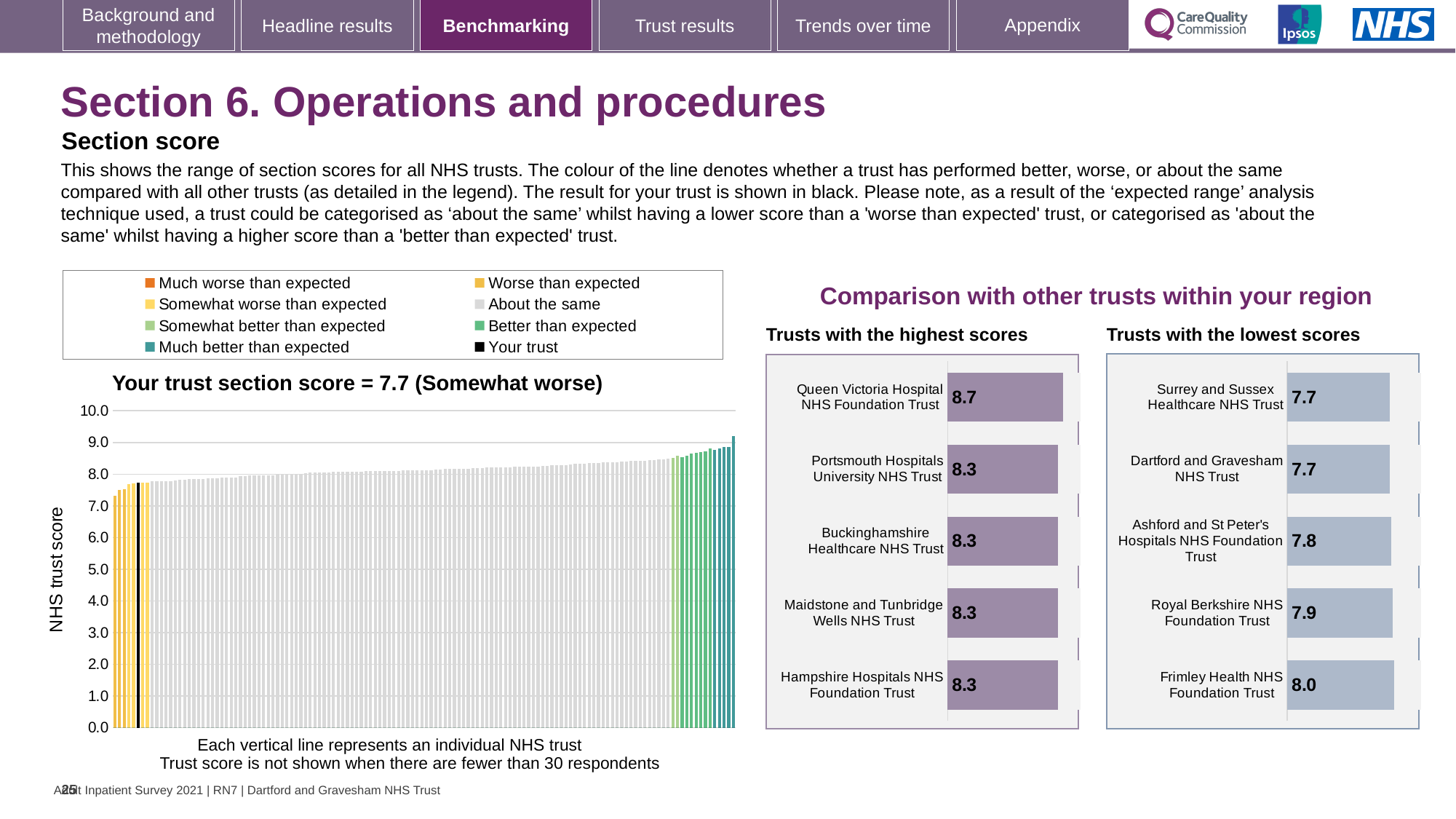
In the 'Trusts with the lowest scores' chart, what is the score for Ashford and St Peter's Hospitals NHS Foundation Trust? 7.8 In the 'Trusts with the highest scores' chart, what is the difference between the scores of Queen Victoria Hospital NHS Foundation Trust and Portsmouth Hospitals University NHS Trust? 0.4 In the 'Trusts with the highest scores' chart, how many trusts are shown? 5 In the 'Trusts with the highest scores' chart, which trust has the highest score? Queen Victoria Hospital NHS Foundation Trust In the 'Your trust section score' chart, do the bar values rise or fall from left to right? rise In the 'Trusts with the highest scores' chart, what is the score for Queen Victoria Hospital NHS Foundation Trust? 8.7 In the 'Trusts with the lowest scores' chart, what is the difference between the scores of Frimley Health NHS Foundation Trust and Surrey and Sussex Healthcare NHS Trust? 0.3 In the 'Trusts with the lowest scores' chart, which is larger: the score for Royal Berkshire NHS Foundation Trust or Dartford and Gravesham NHS Trust? Royal Berkshire NHS Foundation Trust In the 'Trusts with the lowest scores' chart, which trust has the highest score? Frimley Health NHS Foundation Trust How many entries does the legend above the 'Your trust section score' chart list? 8 In the 'Trusts with the lowest scores' chart, what is the score for Frimley Health NHS Foundation Trust? 8.0 In the 'Your trust section score' chart, what is the section score for your trust? 7.7